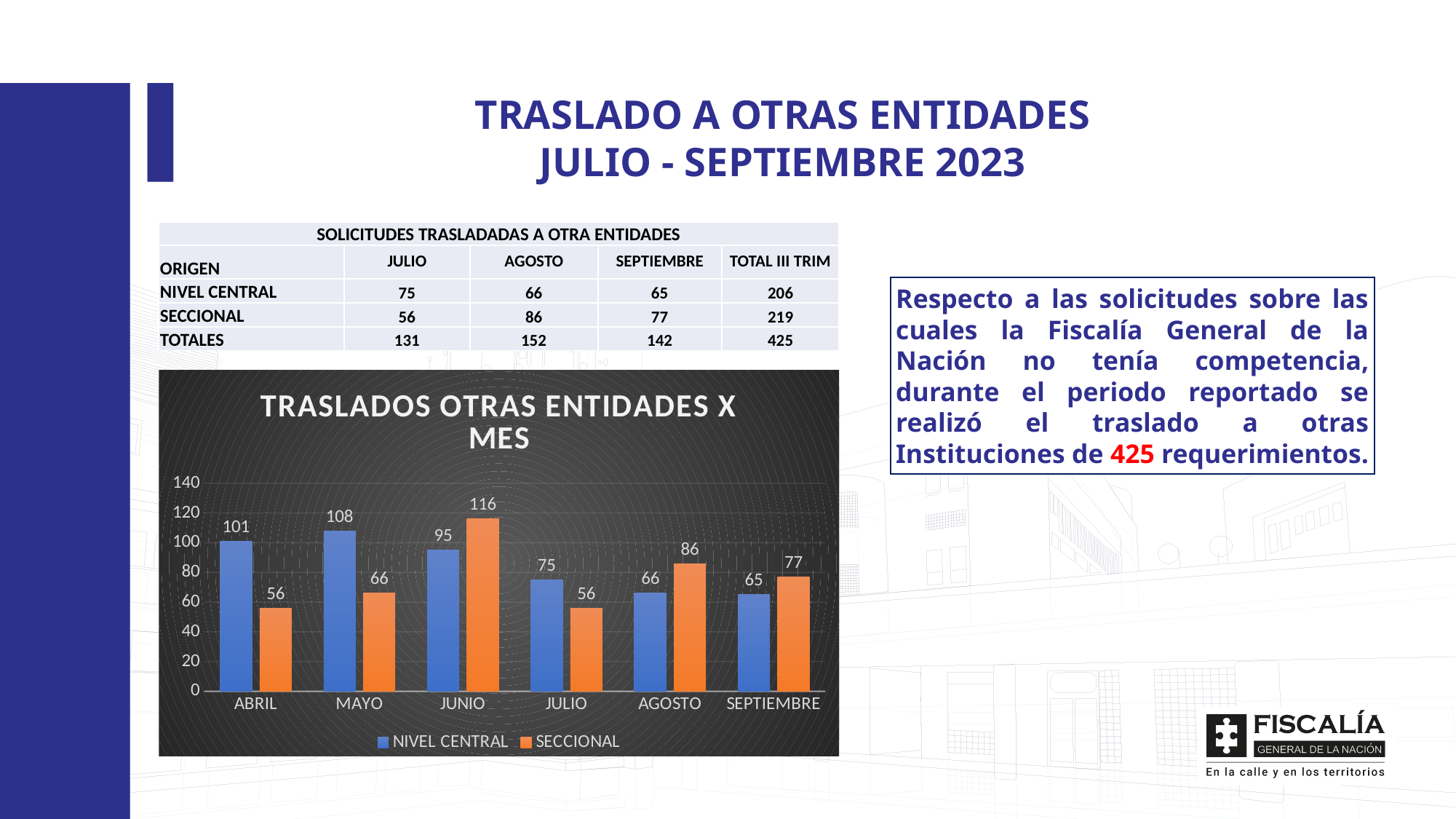
What is the difference between the NIVEL CENTRAL and SECCIONAL values in MAYO? 42 What is the value for NIVEL CENTRAL in JUNIO? 95 How many series does the chart legend list? 2 Which month has the lowest NIVEL CENTRAL value? SEPTIEMBRE What is the title of the chart? TRASLADOS OTRAS ENTIDADES X MES Does the NIVEL CENTRAL value rise or fall from JUNIO to SEPTIEMBRE? Fall In JULIO, which series has the larger value, NIVEL CENTRAL or SECCIONAL? NIVEL CENTRAL What is the value for SECCIONAL in AGOSTO? 86 What kind of chart is shown on the slide? Bar chart Which month has the highest SECCIONAL value? JUNIO How many months are shown on the x axis of the chart? 6 What is the value for NIVEL CENTRAL in SEPTIEMBRE? 65